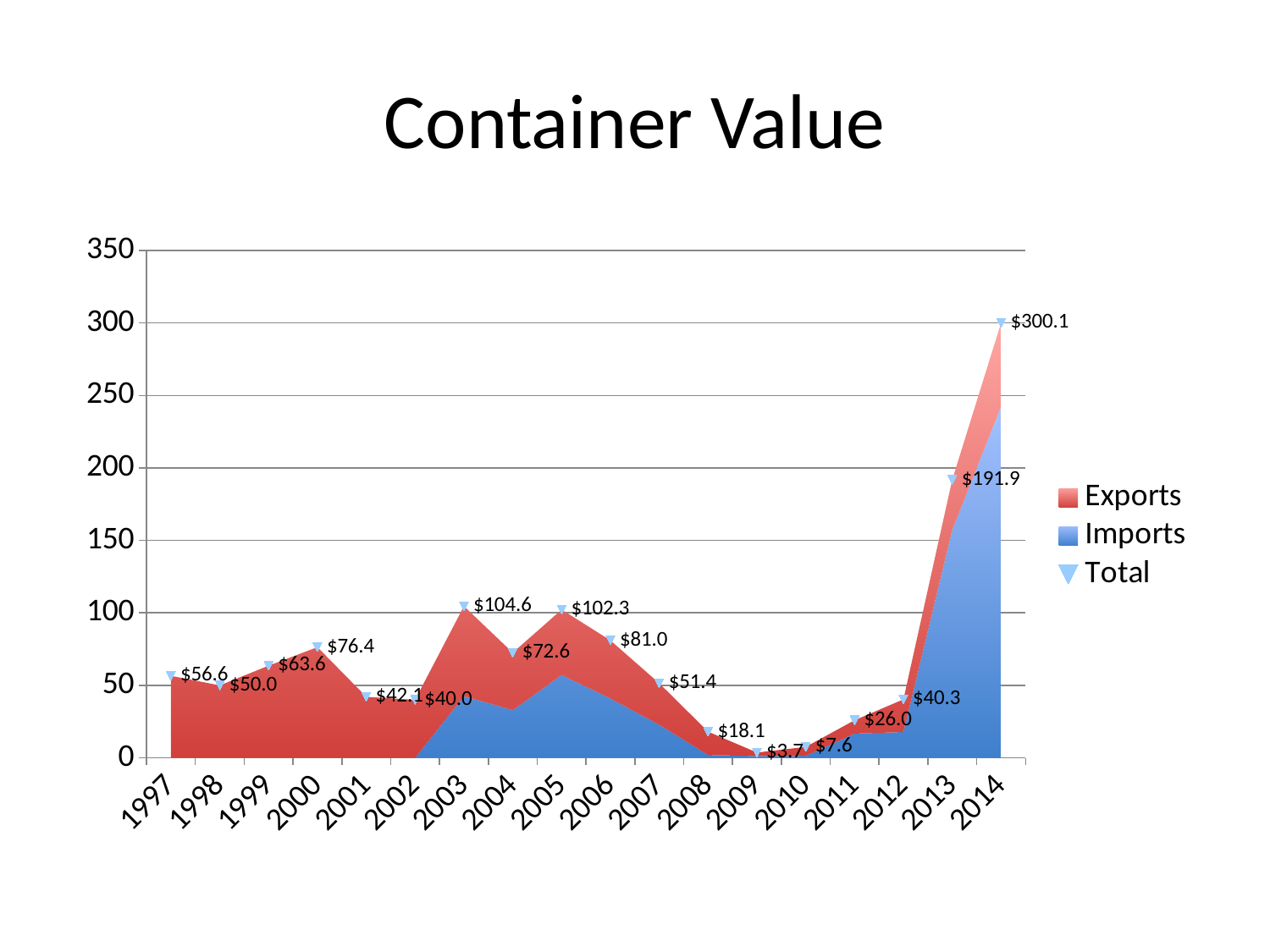
What is the difference between the Total values for 2014 and 2013? $108.2 Which year has the lowest Total value? 2009 What is the Total value for 2003? $104.6 How many series does the legend list? 3 What is the Total value for 2014? $300.1 Which year has a larger Total value, 2000 or 2006? 2006 Which year has the highest Total value? 2014 What kind of chart is shown on the slide? Area chart What is the Total value for 2009? $3.7 Does the Total value rise or fall from 2009 to 2014? Rise How many years are shown on the x axis? 18 Is the Imports value for 2014 greater or less than 200? greater